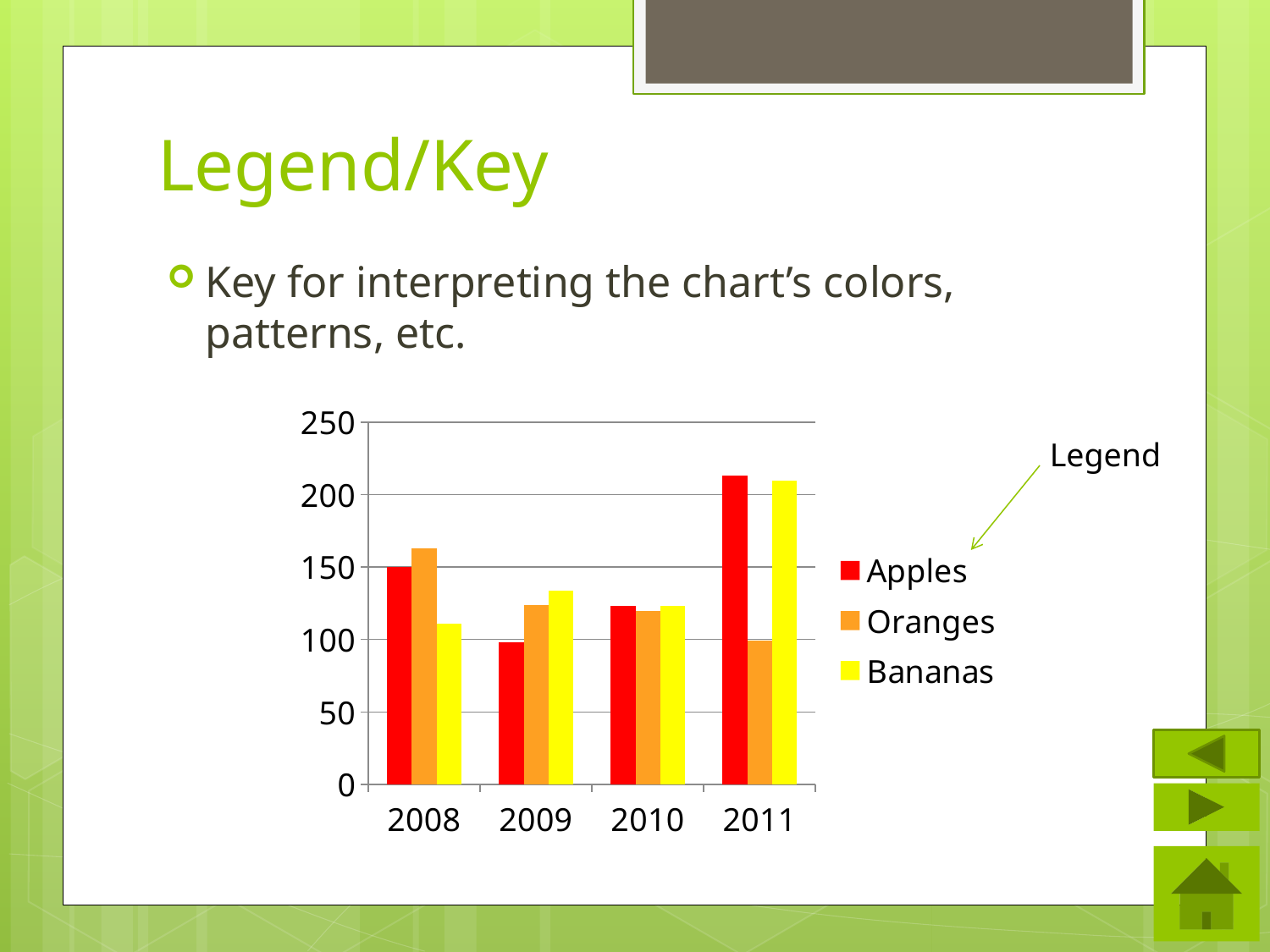
What kind of chart is shown on the slide? bar chart In which year is the Apples bar the lowest? 2009 Is the value for Apples in 2011 greater or less than 200? greater In 2011, which is larger: Apples or Oranges? Apples Is the value for Bananas in 2011 greater or less than 200? greater What colour represents Apples in the chart's legend? red How many years are shown on the x axis of the chart? 4 Is the value for Oranges in 2009 greater or less than 100? greater How many series does the chart's legend list? 3 In 2008, which is larger: Oranges or Bananas? Oranges In which year is the Apples bar the highest? 2011